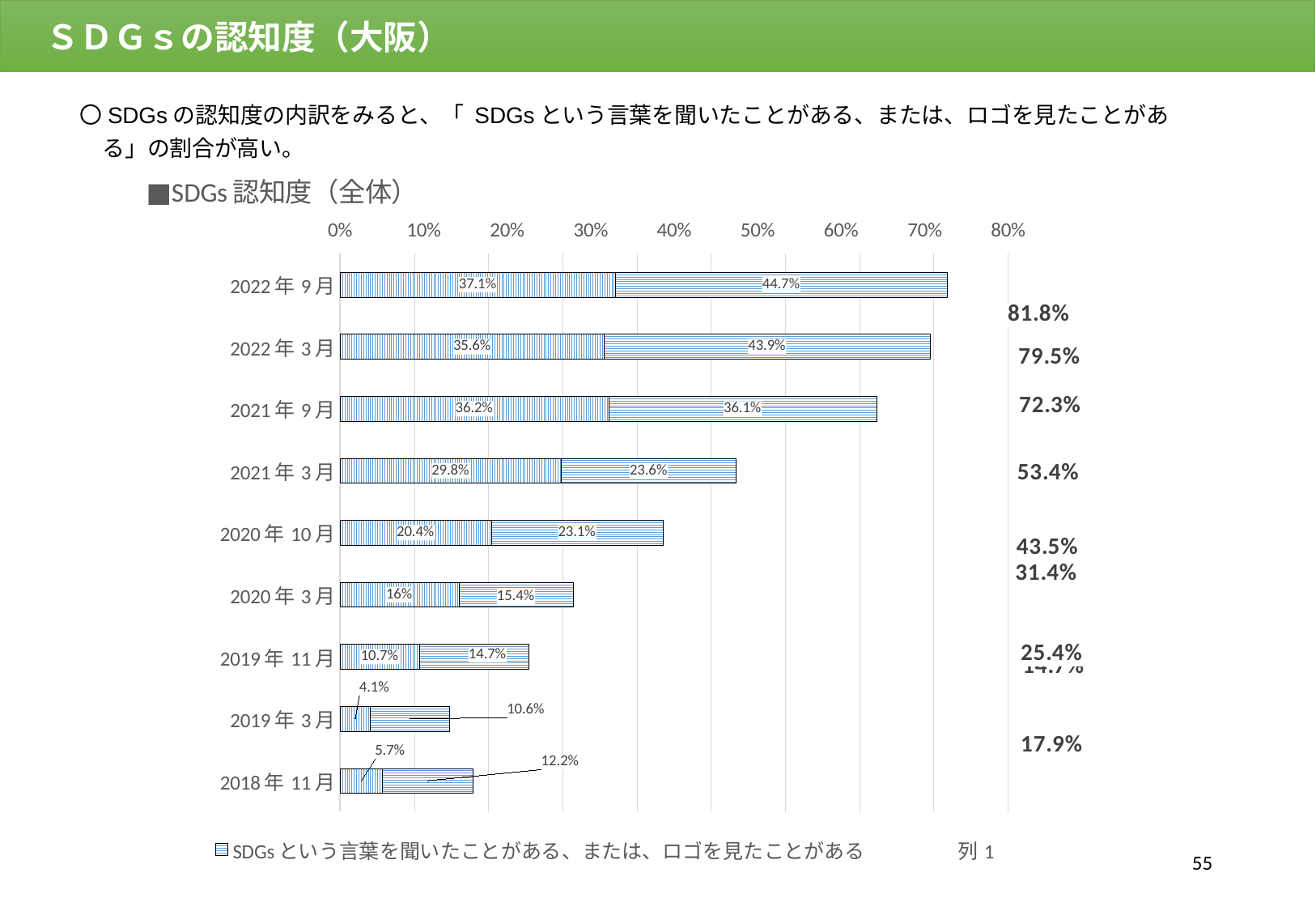
For 2022年9月, what is the difference between the second series value (44.7%) and the first series value (37.1%)? 7.6 percentage points How many time-period categories are plotted on the chart? 9 What is the value of the first series (SDGsという言葉を聞いたことがある、または、ロゴを見たことがある) for 2022年9月? 44.7% Do the total bar lengths increase or decrease going from 2018年11月 up to 2022年9月? increase What kind of chart is shown on the slide? bar chart Which category has the lowest value for the first series (SDGsという言葉を聞いたことがある、または、ロゴを見たことがある)? 2019年3月 Which category has the highest value for the second series (列1)? 2022年9月 What is the total of the stacked bar for 2022年3月? 79.5% For 2020年10月, which is larger: the first series value or the second series (列1) value? the second series (列1), 43.5% What is the value of the second series (列1) for 2021年3月? 53.4% How many series does the legend list? 2 What is the value of the second series (列1) for 2018年11月? 17.9%